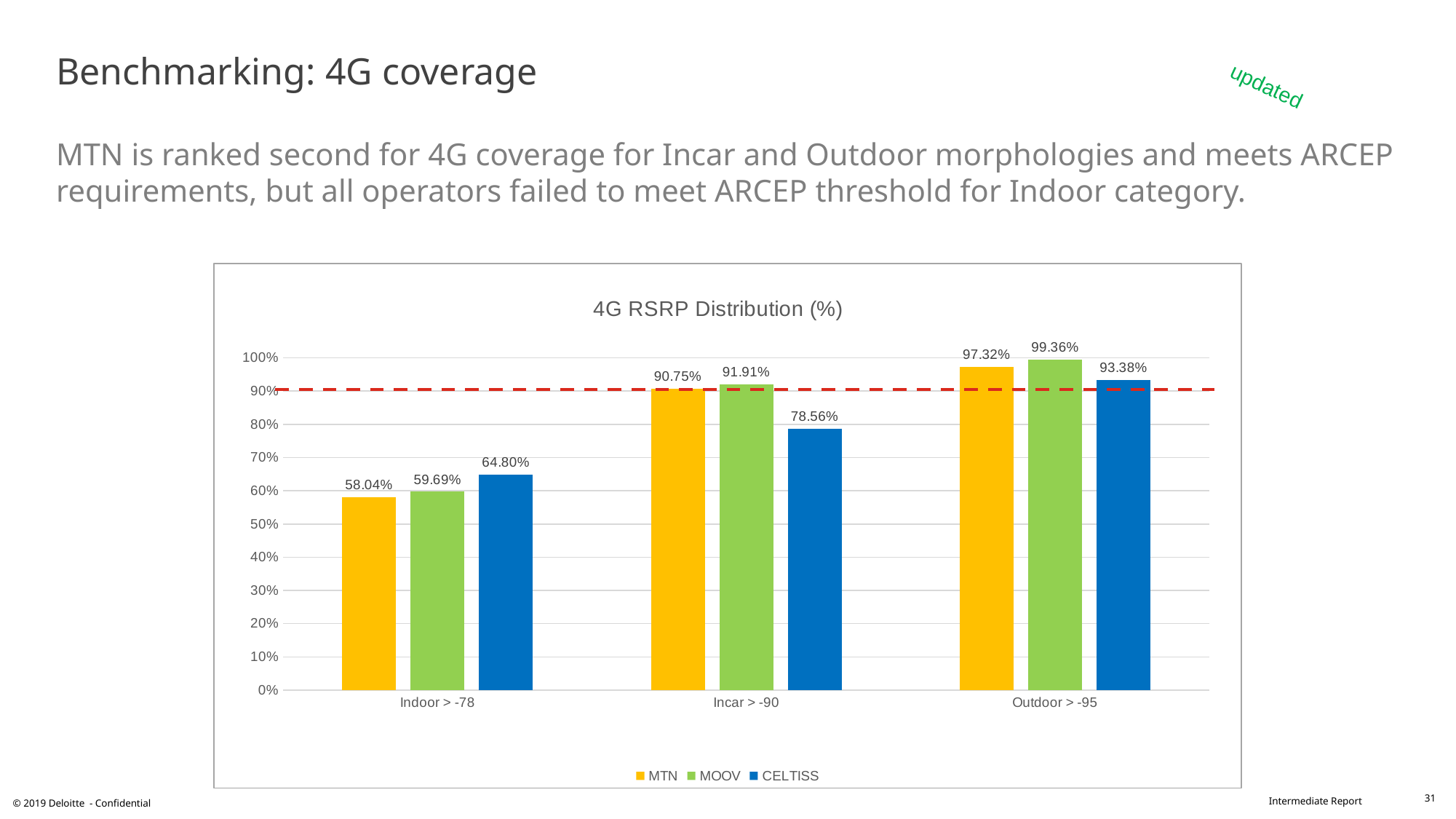
Which operator has the highest value in the Outdoor > -95 category? MOOV How many series does the legend list? 3 How many categories are shown on the x axis? 3 What is the value for MTN in the Indoor > -78 category? 58.04% What is the value for CELTISS in the Incar > -90 category? 78.56% What kind of chart is shown on the slide? Bar chart What is the value for MOOV in the Outdoor > -95 category? 99.36% Which is larger in the Indoor > -78 category: CELTISS or MOOV? CELTISS What is the title of the chart? 4G RSRP Distribution (%) What is the difference between MOOV and MTN in the Incar > -90 category? 1.16% Which operator has the lowest value in the Indoor > -78 category? MTN Is the value for CELTISS in the Incar > -90 category greater or less than 80%? less